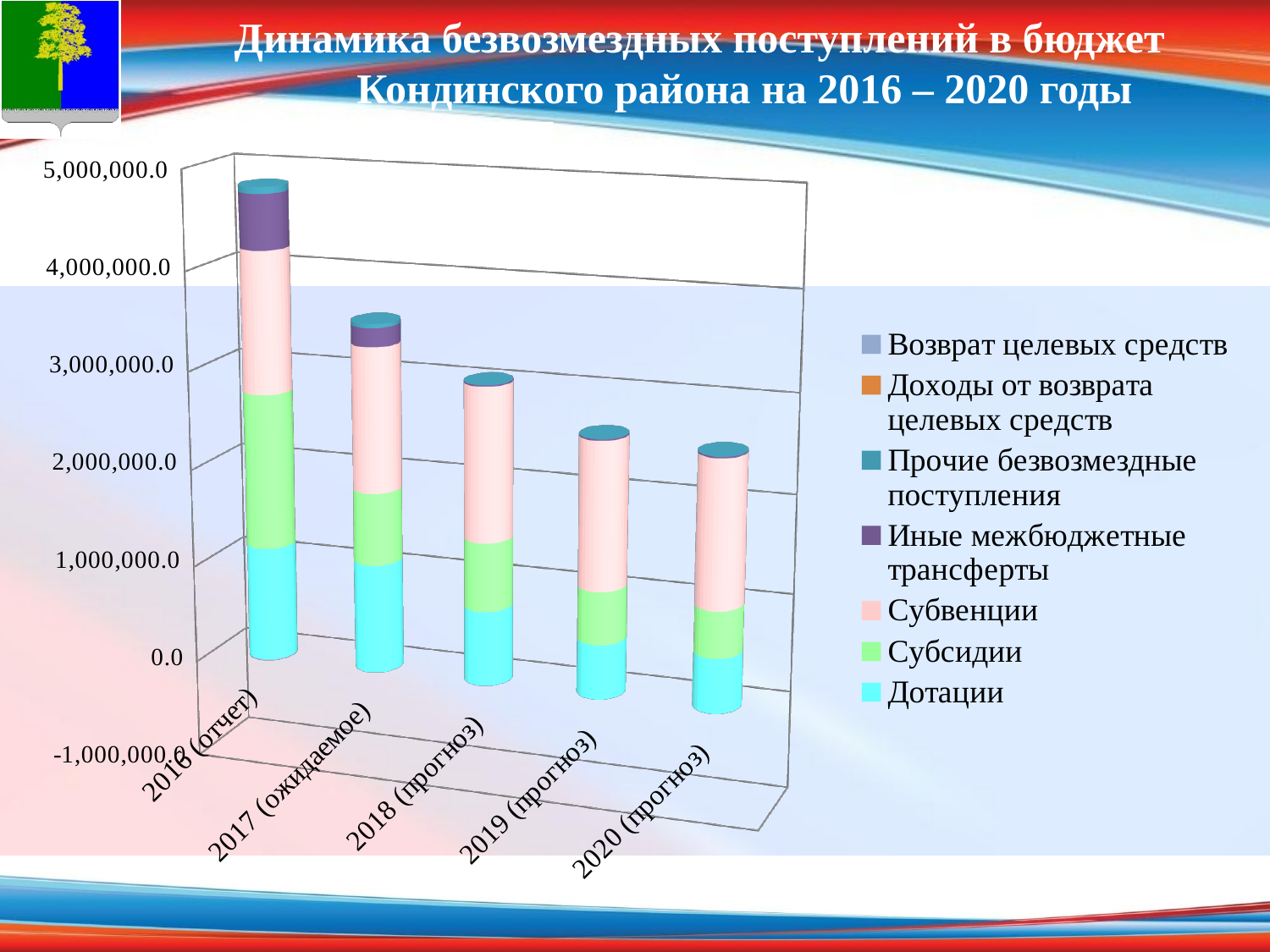
Which legend entry is shown at the bottom of the legend? Дотации Is the total value for 2020 (прогноз) greater or less than 3,000,000.0? less What is the title of the chart on the slide? Динамика безвозмездных поступлений в бюджет Кондинского района на 2016 – 2020 годы How many series does the chart legend list? 7 What kind of chart is shown on the slide? Stacked bar chart How many year categories are shown on the x axis of the chart? 5 Which year has the highest total bar in the chart? 2016 (отчет) Which year has the larger Субсидии segment: 2016 (отчет) or 2020 (прогноз)? 2016 (отчет) Which total bar is larger: 2016 (отчет) or 2020 (прогноз)? 2016 (отчет) Is the total value for 2017 (ожидаемое) greater or less than 3,000,000.0? greater Do the total bar heights rise or fall from 2016 to 2020? Fall Is the total value for 2016 (отчет) greater or less than 4,000,000.0? greater